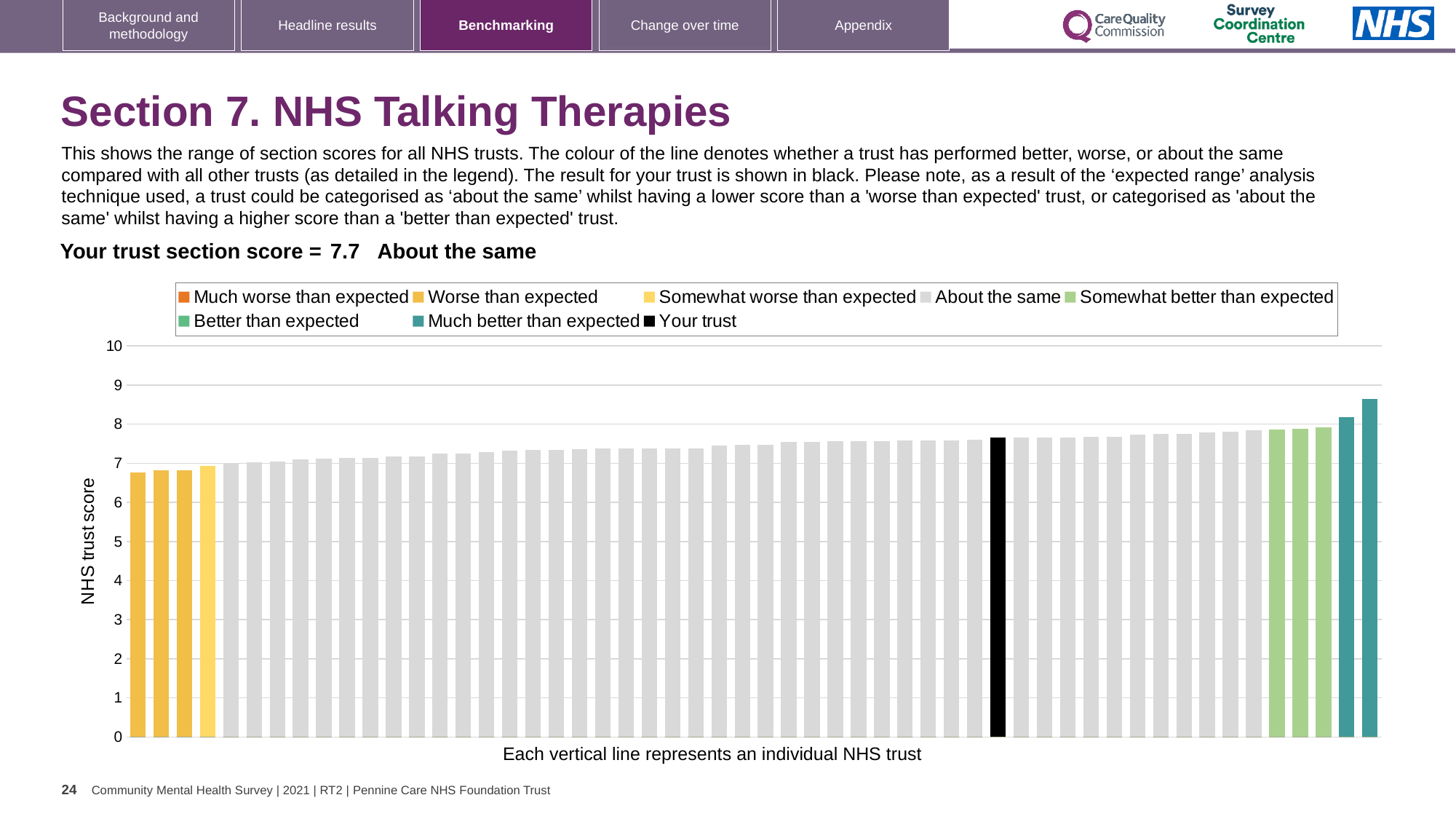
What colour is used for the bar representing your trust? black Is the value of the tallest bar greater or less than 9? less Is the value of the leftmost bar greater or less than 6? greater Is the value of the black bar (your trust) greater or less than 7? greater How many entries does the chart legend list? 8 What is the section score for your trust shown on the slide? 7.7 What kind of chart is shown on the slide? bar chart Which is larger, the rightmost bar or the black bar for your trust? the rightmost bar Which benchmarking category is your trust placed in for Section 7? About the same How many bars are coloured as 'Much better than expected' (teal)? 2 Do the bar values rise or fall from left to right along the x axis? rise What is the title of the vertical axis? NHS trust score